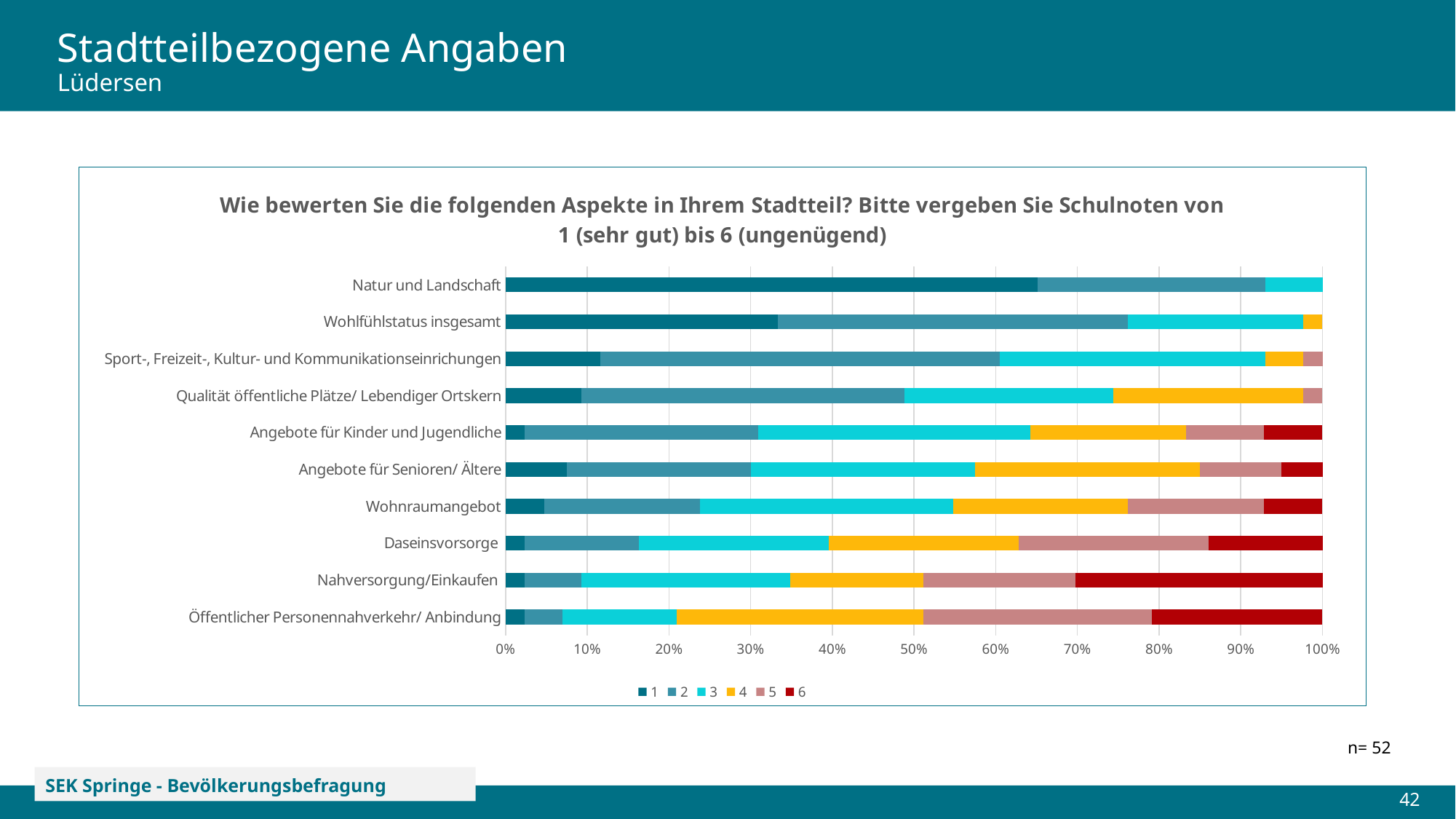
How many series does the chart legend list? 6 How many aspects (categories) are listed on the vertical axis of the chart? 10 Which has a larger share of grade 1: Natur und Landschaft or Wohlfühlstatus insgesamt? Natur und Landschaft Is the share of grade 1 for Natur und Landschaft greater or less than 60%? greater What kind of chart is shown on the slide? Stacked bar chart Which aspect has the largest share of grade 6 (red segment)? Nahversorgung/Einkaufen What are the entries listed in the chart legend? 1, 2, 3, 4, 5, 6 Is the share of grade 6 for Nahversorgung/Einkaufen greater or less than 20%? greater Is the share of grade 1 for Wohlfühlstatus insgesamt greater or less than 40%? less Which has a larger share of grade 6: Nahversorgung/Einkaufen or Daseinsvorsorge? Nahversorgung/Einkaufen Which aspect has the largest share of grade 1 (darkest segment)? Natur und Landschaft